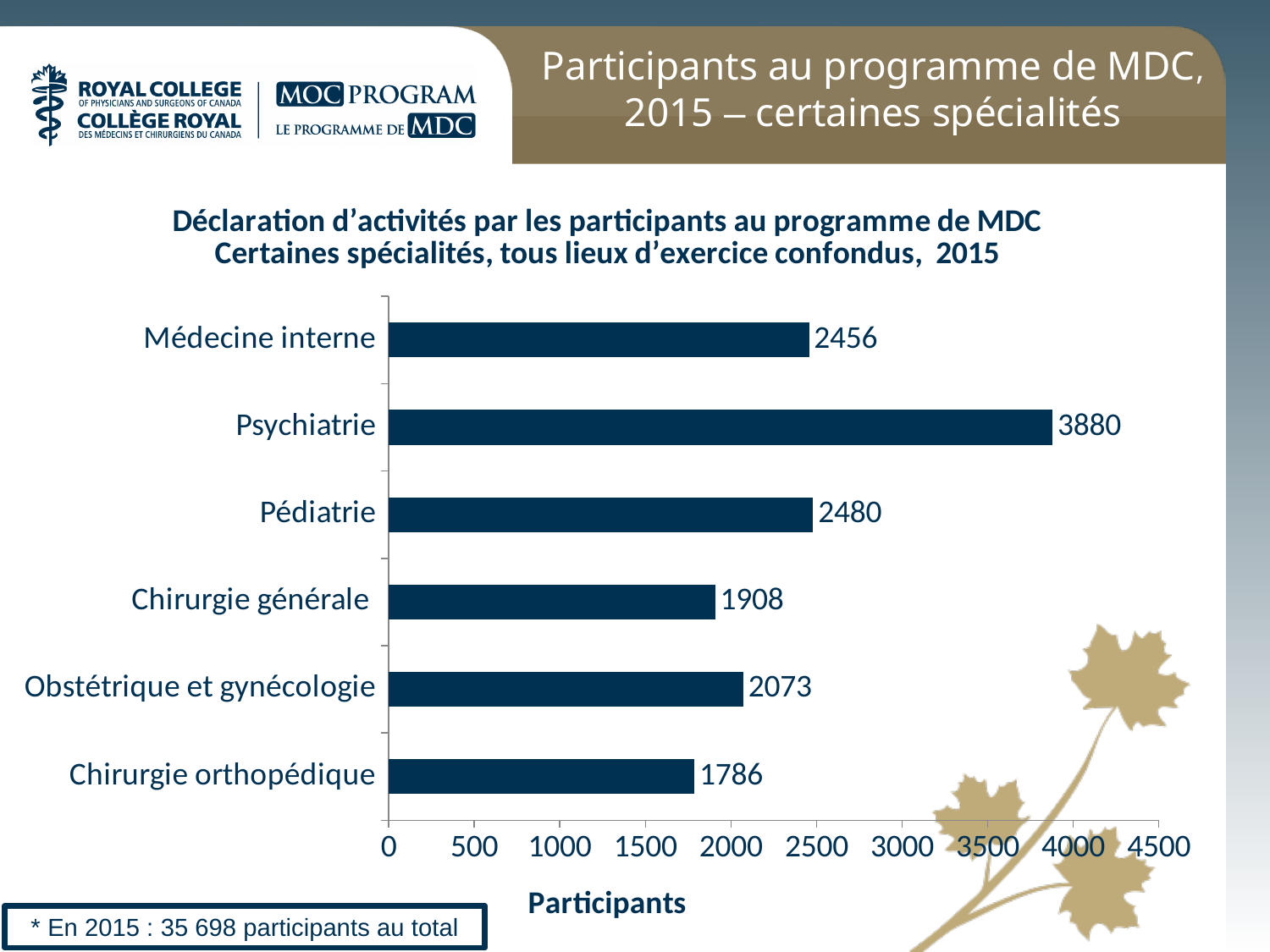
What kind of chart is shown on the slide? Bar chart What is the label of the horizontal axis of the chart? Participants How many specialties are shown in the chart? 6 What is the number of participants for Chirurgie orthopédique? 1786 What is the number of participants for Psychiatrie? 3880 Which has more participants, Pédiatrie or Médecine interne? Pédiatrie What is the number of participants for Obstétrique et gynécologie? 2073 Which specialty has the lowest number of participants? Chirurgie orthopédique Which specialty has the highest number of participants? Psychiatrie What is the difference in participants between Obstétrique et gynécologie and Chirurgie générale? 165 What is the difference in participants between Psychiatrie and Médecine interne? 1424 Is the value for Chirurgie générale greater or less than 2000? less